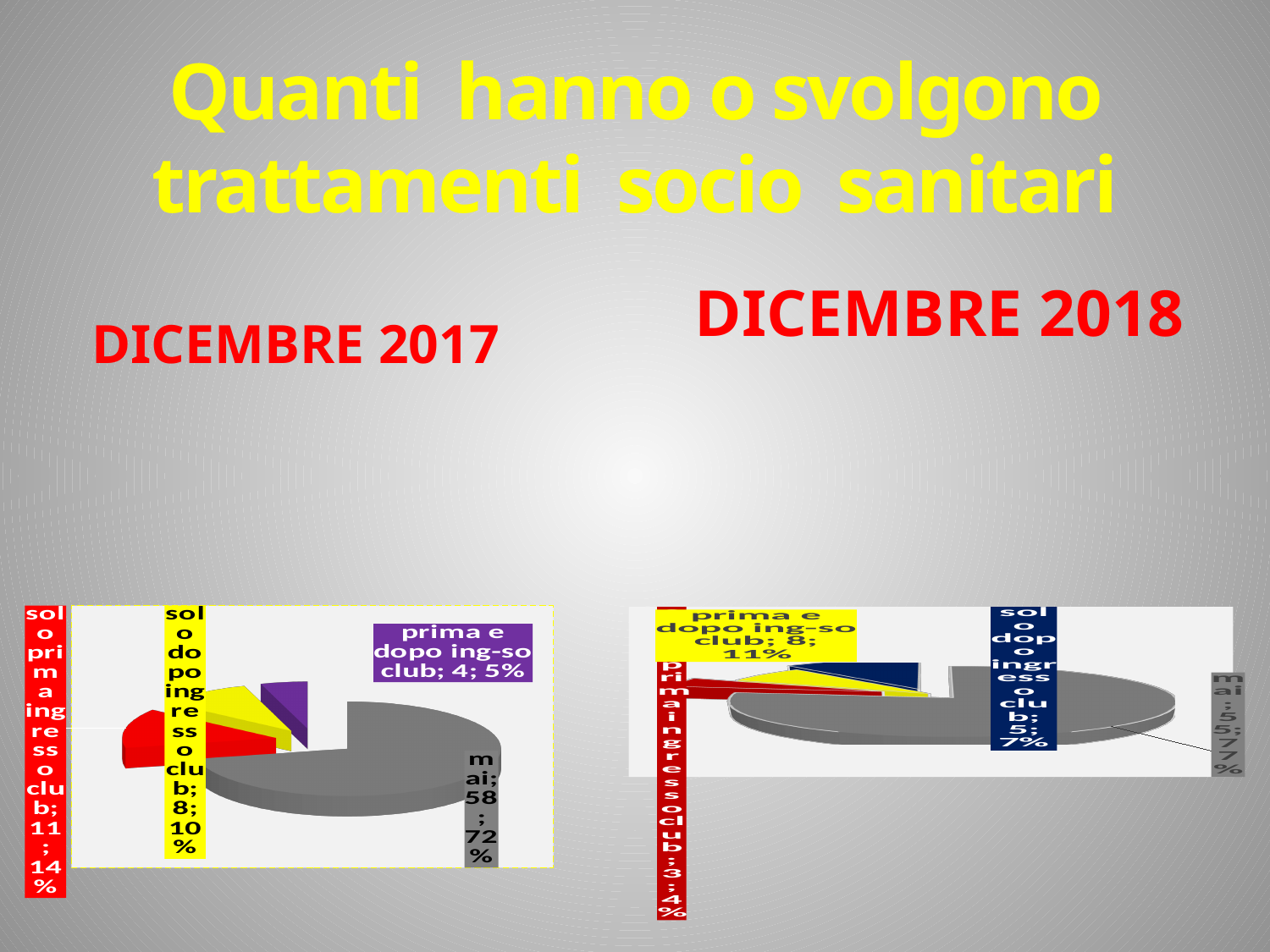
In the DICEMBRE 2017 chart, what is the count for 'solo dopo ingresso club'? 8 In the DICEMBRE 2017 chart, what is the value for 'mai'? 58; 72% What is the difference between the 'mai' counts in the DICEMBRE 2017 and DICEMBRE 2018 charts? 3 In the DICEMBRE 2017 chart, which category has the smallest share? prima e dopo ing-so club In the DICEMBRE 2018 chart, which category has the largest share? mai In the DICEMBRE 2018 chart, what percentage is shown for 'prima e dopo ing-so club'? 11% In the DICEMBRE 2017 chart, what percentage is shown for 'solo prima ingresso club'? 14% What kind of chart is shown under DICEMBRE 2017? pie chart Which is larger: 'solo dopo ingresso club' in the DICEMBRE 2017 chart or in the DICEMBRE 2018 chart? DICEMBRE 2017 In the DICEMBRE 2017 chart, how many slices does the pie have? 4 In the DICEMBRE 2018 chart, what is the value for 'mai'? 55; 77% In the DICEMBRE 2018 chart, what is the count for 'solo prima ingresso club'? 3